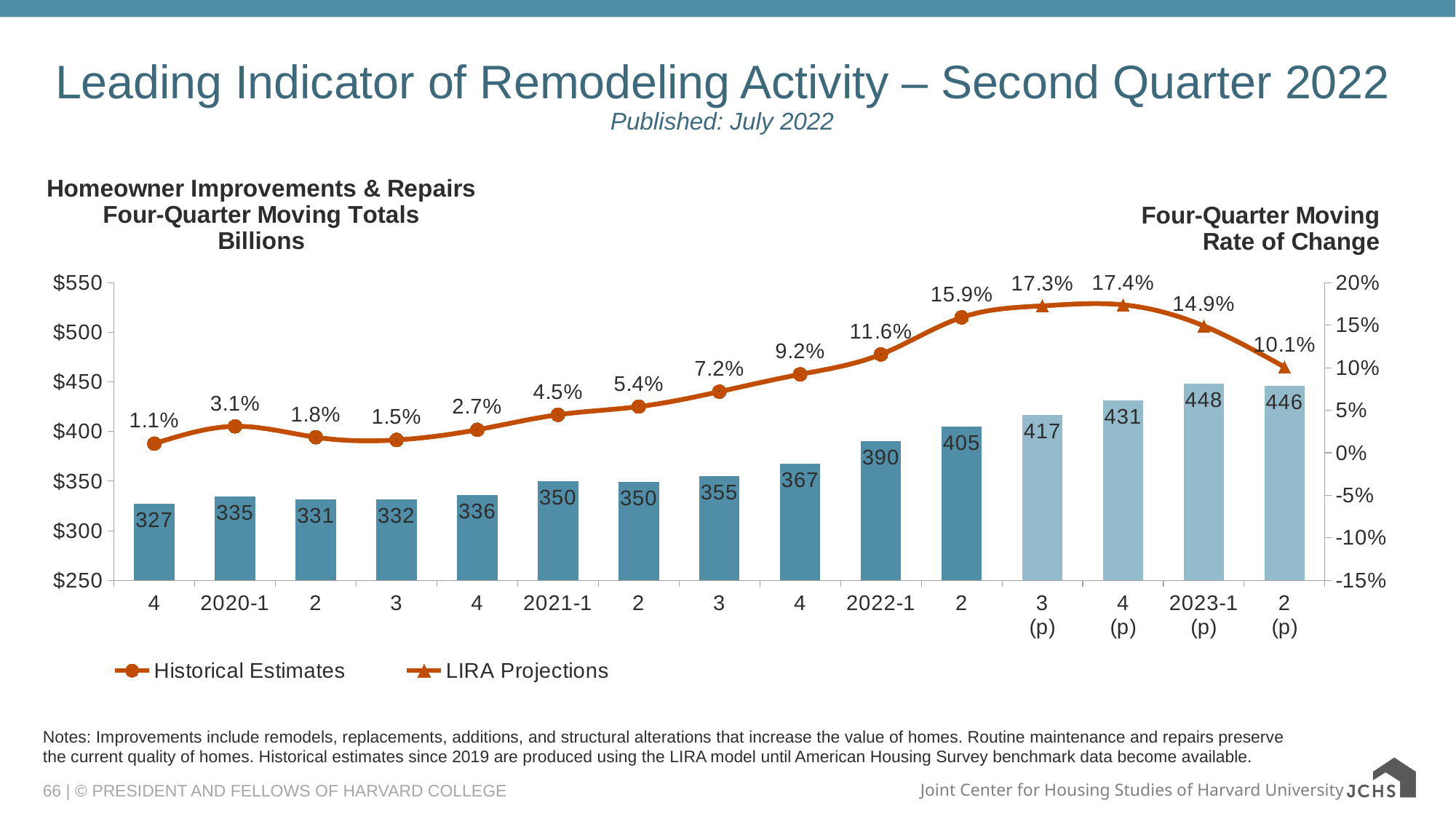
What is the projected four-quarter moving total for 2023-1 (p)? 448 What is the difference between the four-quarter moving totals for 2022-2 and 2022-1? 15 What is the four-quarter moving total (in billions) for 2022-1? 390 Which is larger, the four-quarter moving total for 2022-1 or for quarter 2 of 2022? Quarter 2 of 2022 What is the lowest four-quarter moving total shown on the chart? 327 Is the four-quarter moving total bar for 2023-1 (p) greater or less than $400? greater What is the four-quarter moving rate of change for quarter 2 of 2022? 15.9% How many series does the legend list? 2 How many quarterly periods are shown on the x axis? 15 What is the highest four-quarter moving rate of change shown on the line? 17.4% Which period has the highest four-quarter moving total bar? 2023-1 (p) What kind of chart is shown on the slide? Combination bar and line chart